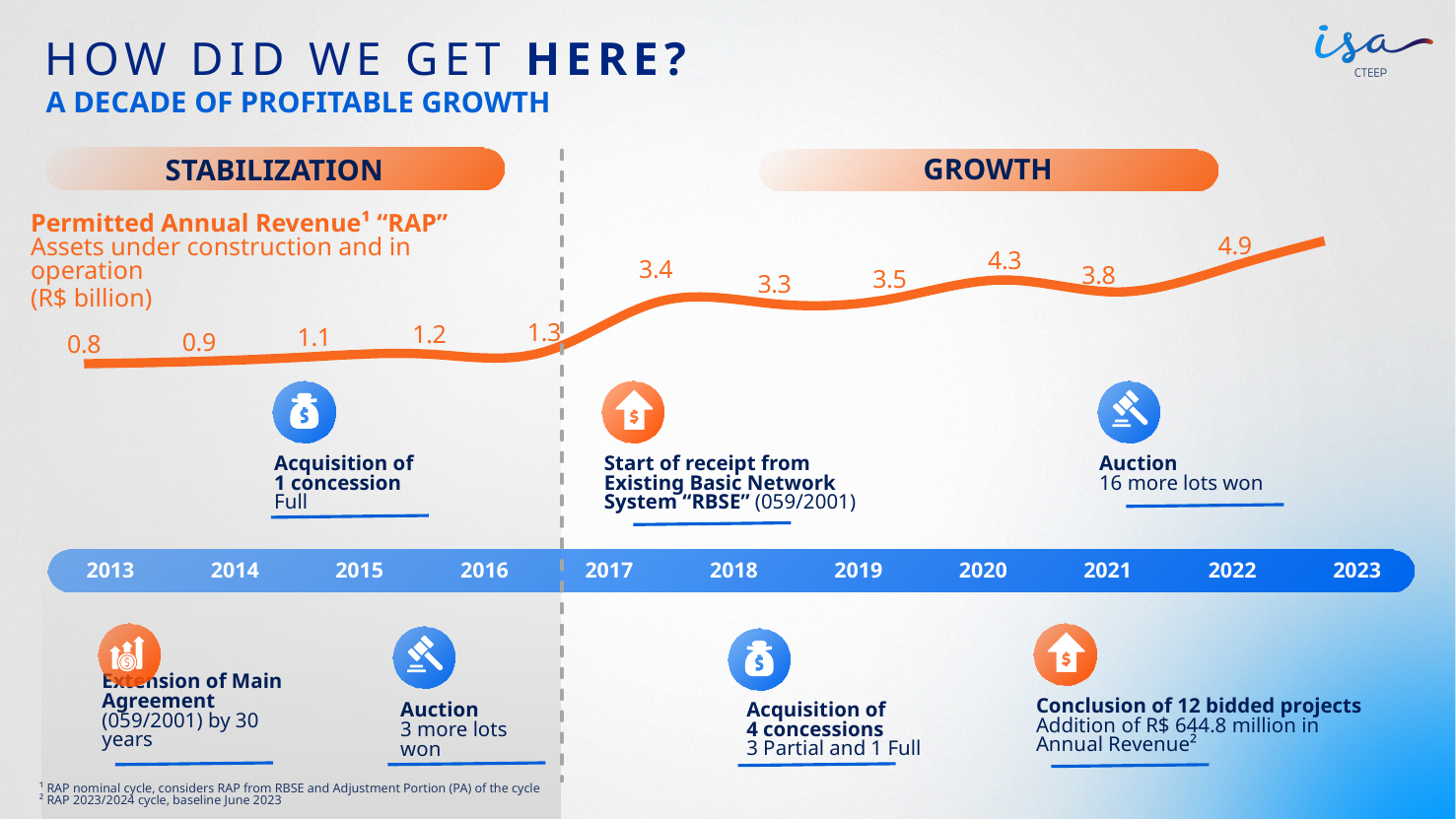
Which year has the highest RAP value on the chart? 2023 In what unit are the RAP values on the chart expressed? R$ billion What kind of chart is used to show the Permitted Annual Revenue? Line chart Which year has the lowest RAP value on the chart? 2013 Do the RAP values generally rise or fall from 2013 to 2023? Rise